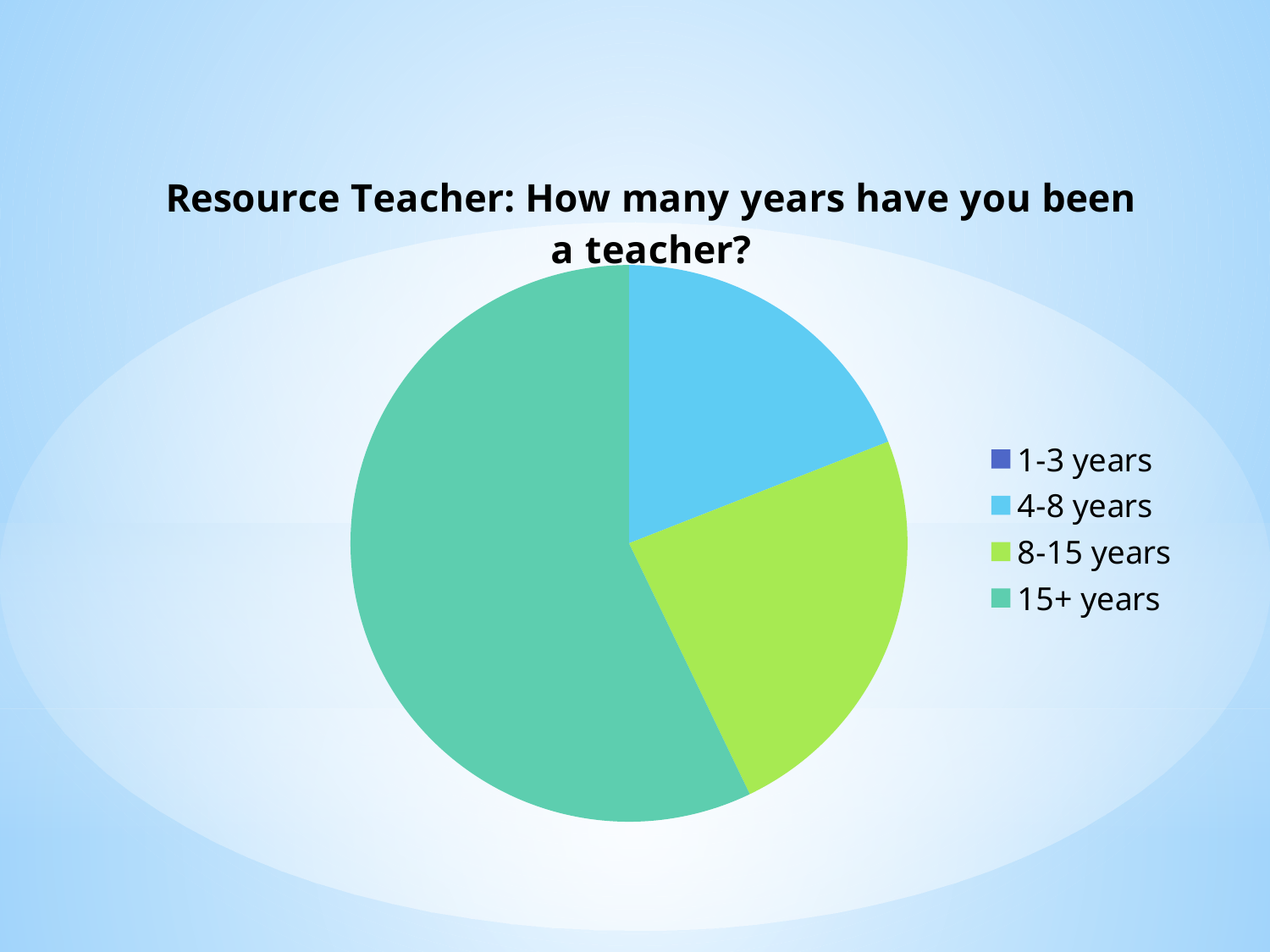
Which category has the largest slice of the pie? 15+ years Which slice is larger, 15+ years or 4-8 years? 15+ years What is the title of the chart? Resource Teacher: How many years have you been a teacher? What kind of chart is shown on the slide? pie chart Which colour represents the 15+ years category in the legend? green (teal) Which slice is larger, 8-15 years or 4-8 years? 8-15 years Does the 15+ years slice take up more or less than half of the pie? more How many categories does the legend list? 4 Which slice is larger, 15+ years or 8-15 years? 15+ years